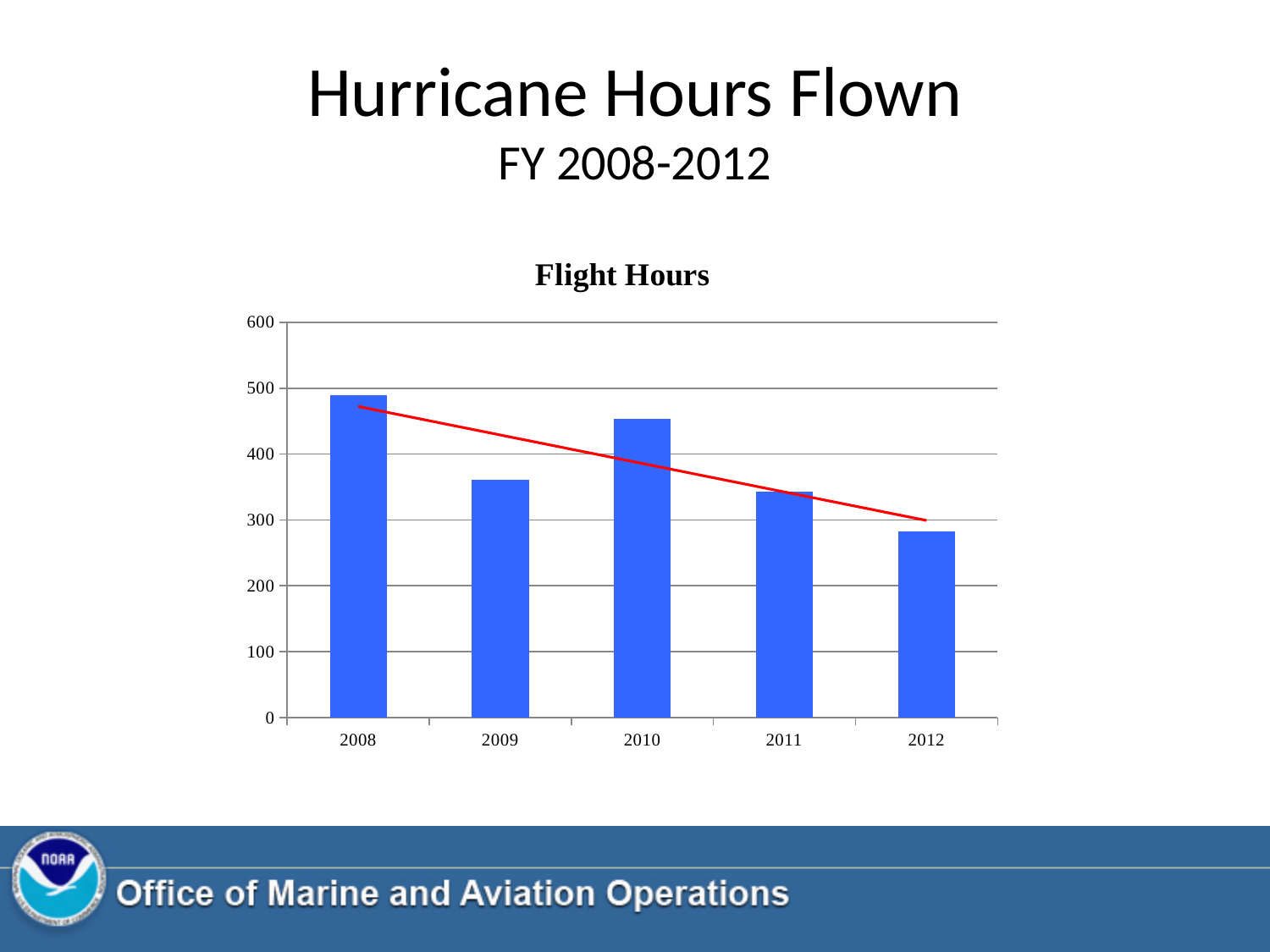
What kind of chart is shown on the slide? bar chart Which year has the highest flight hours? 2008 What is the title of the chart? Flight Hours Do the flight hours generally rise or fall from 2008 to 2012? fall Is the value for 2009 greater or less than 400? less Is the value for 2008 greater or less than 400? greater Which year has the lowest flight hours? 2012 Is the value for 2010 greater or less than 500? less Which year has more flight hours, 2009 or 2010? 2010 How many years are plotted on the x axis of the Flight Hours chart? 5